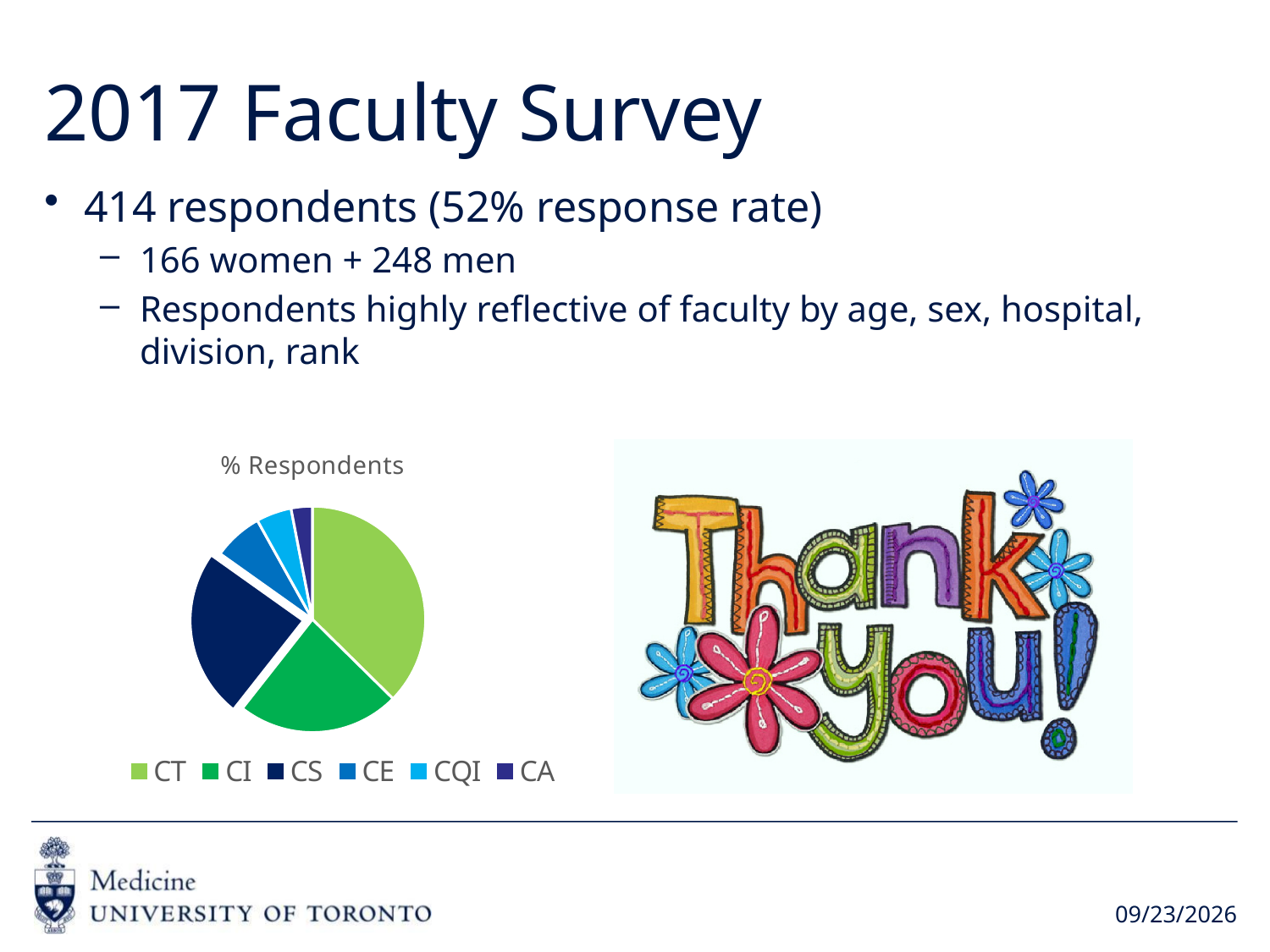
In the % Respondents pie chart, which slice is larger, CS or CQI? CS In the % Respondents pie chart, which slice is larger, CI or CQI? CI What kind of chart is shown on the slide? pie chart In the % Respondents pie chart, which slice is larger, CE or CA? CE How many categories does the legend of the pie chart list? 6 Which category has the largest slice in the % Respondents pie chart? CT What is the title of the chart on the slide? % Respondents Which category is listed first in the legend of the pie chart? CT Which category has the smallest slice in the % Respondents pie chart? CA